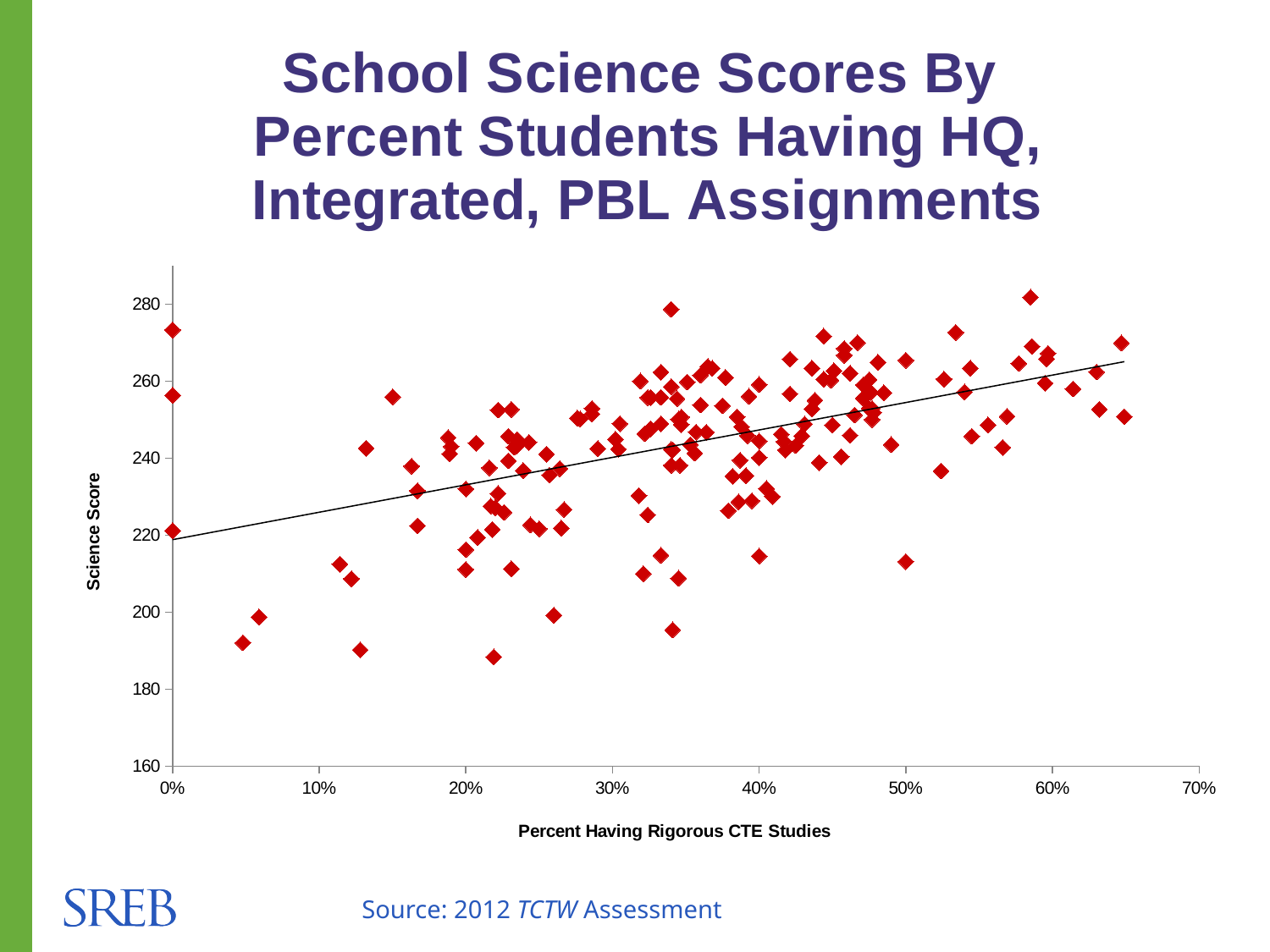
What kind of chart is shown on the slide? scatter chart Do the science scores generally rise or fall as the percent having rigorous CTE studies increases? rise Is the lowest plotted science score greater or less than 180? greater Is the lowest plotted science score greater or less than 200? less What is the title of the y axis? Science Score What is the title of the x axis? Percent Having Rigorous CTE Studies Does the fitted trend line slope upward or downward from left to right? upward